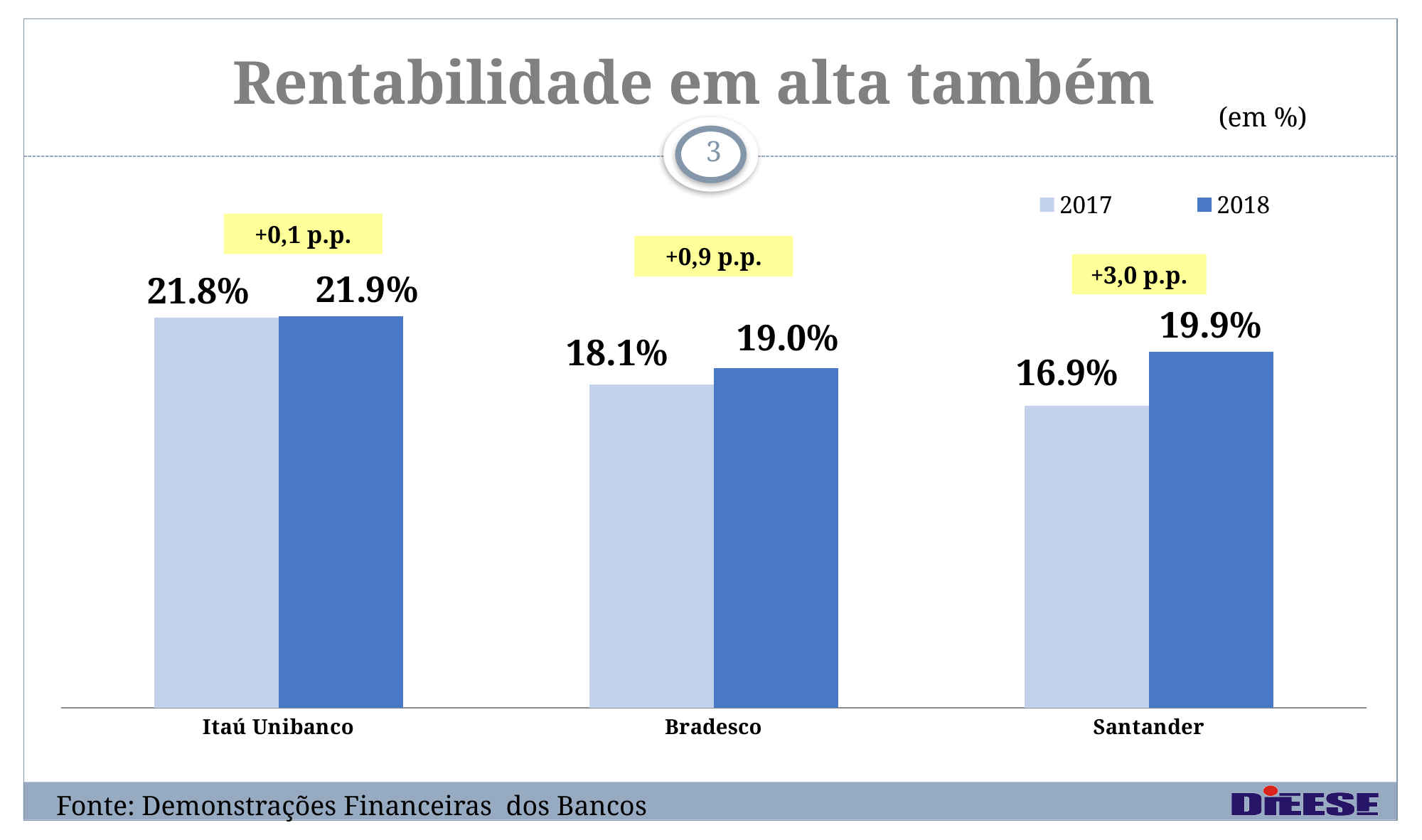
What is the difference between Itaú Unibanco's and Bradesco's 2018 values? 2.9 percentage points How many banks are shown on the chart? 3 How many series does the legend list? 2 What is the value for Itaú Unibanco in 2017? 21.8% Which is larger: Bradesco's 2018 value or Santander's 2018 value? Santander's 2018 value What is the value for Bradesco in 2017? 18.1% What kind of chart is shown on the slide? Bar chart What is the title of the slide? Rentabilidade em alta também What is the value for Santander in 2018? 19.9% Which bank has the lowest value in 2017? Santander What is the difference between Santander's 2018 and 2017 values? 3.0 percentage points Which bank has the highest value in 2018? Itaú Unibanco